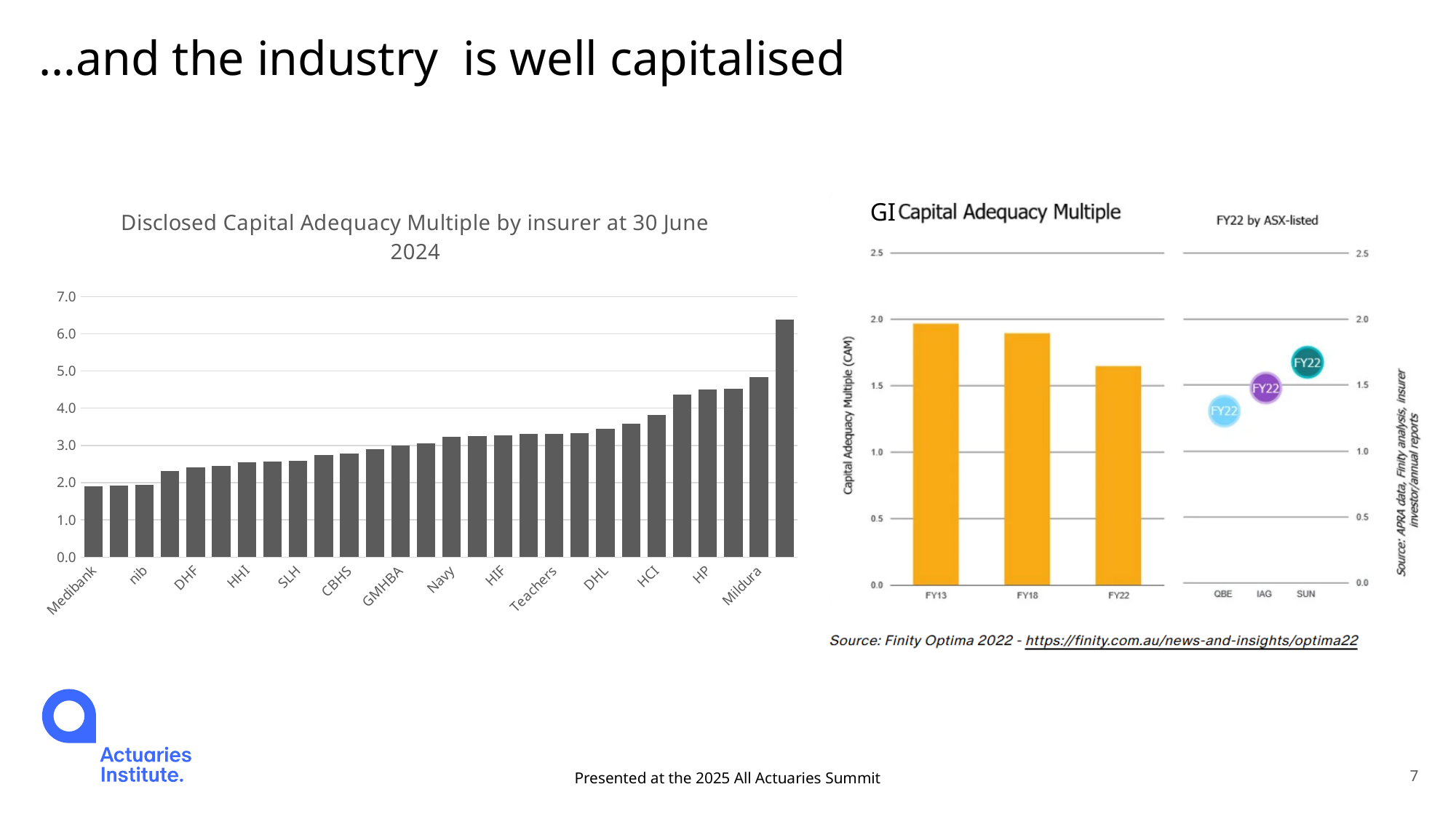
In the right chart 'GI Capital Adequacy Multiple', do the bar values rise or fall from FY13 to FY22? Fall In the left chart 'Disclosed Capital Adequacy Multiple by insurer at 30 June 2024', is the value for Mildura greater or less than 4.0? greater In the 'FY22 by ASX-listed' panel of the right chart, which insurer has the highest capital adequacy multiple? SUN In the right chart 'GI Capital Adequacy Multiple', which financial year has the lowest bar? FY22 In the left chart 'Disclosed Capital Adequacy Multiple by insurer at 30 June 2024', do the bar values generally rise or fall from left to right? Rise In the left chart 'Disclosed Capital Adequacy Multiple by insurer at 30 June 2024', which has the larger value, HP or DHF? HP In the right chart 'GI Capital Adequacy Multiple', which financial year has the highest bar? FY13 In the left chart 'Disclosed Capital Adequacy Multiple by insurer at 30 June 2024', which has the larger value, HCI or CBHS? HCI What type of chart is the left chart titled 'Disclosed Capital Adequacy Multiple by insurer at 30 June 2024'? Bar chart In the left chart 'Disclosed Capital Adequacy Multiple by insurer at 30 June 2024', is the value for DHF greater or less than 3.0? less In the right chart 'GI Capital Adequacy Multiple', how many financial-year bars are shown? 3 In the right chart 'GI Capital Adequacy Multiple', is the value for FY22 greater or less than 1.5? greater